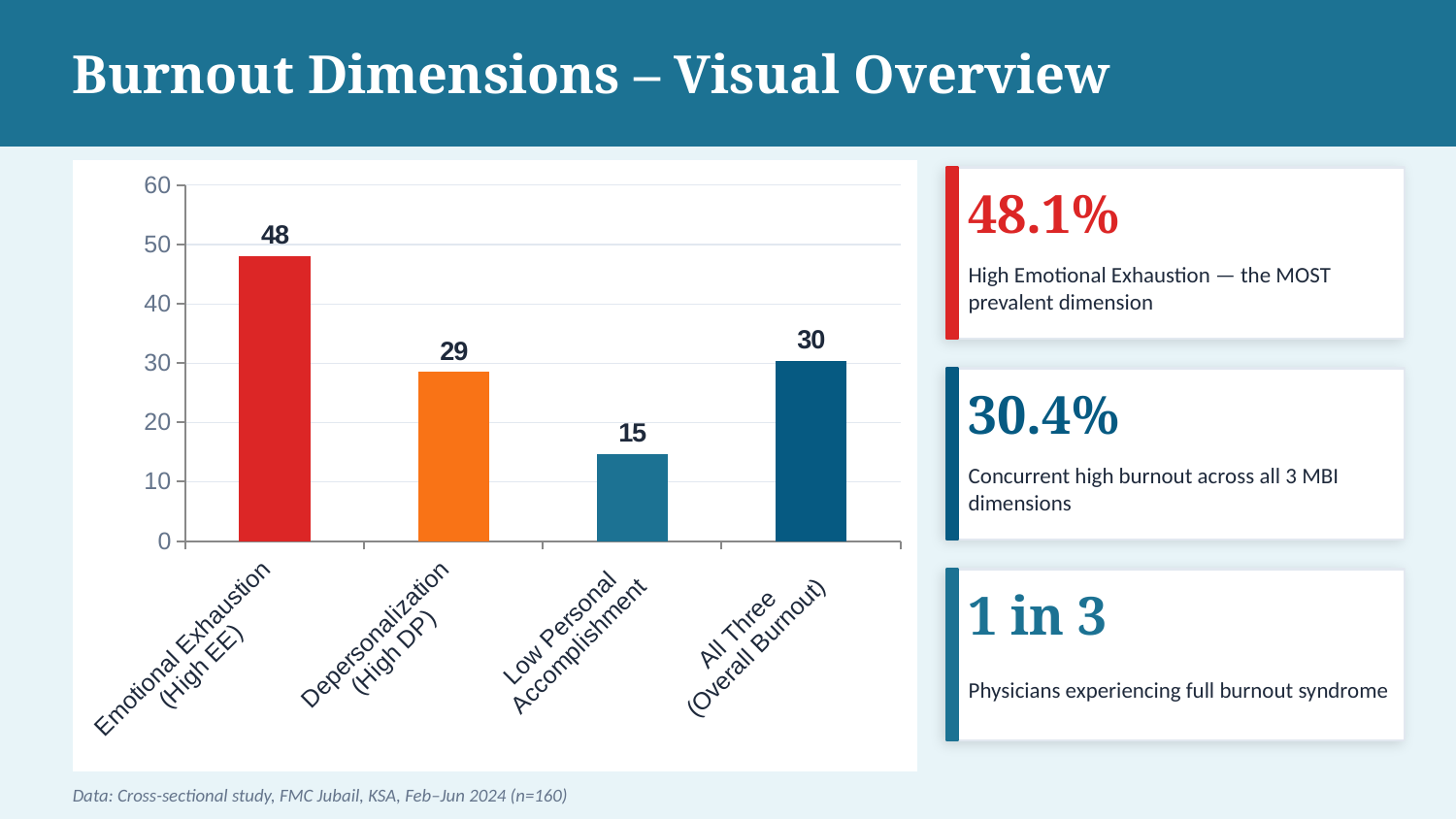
What kind of chart is shown on the slide? Bar chart Which is larger, the value for Depersonalization (High DP) or the value for All Three (Overall Burnout)? All Three (Overall Burnout) What is the value for Low Personal Accomplishment? 15 What is the value for All Three (Overall Burnout)? 30 Which category has the lowest value? Low Personal Accomplishment How many categories are shown on the chart? 4 What is the difference between the values for Emotional Exhaustion (High EE) and Low Personal Accomplishment? 33 What is the value for Emotional Exhaustion (High EE)? 48 What colour is the bar for Depersonalization (High DP)? Orange Which category has the highest value? Emotional Exhaustion (High EE) Is the value for Emotional Exhaustion (High EE) greater or less than 40? greater What is the value for Depersonalization (High DP)? 29